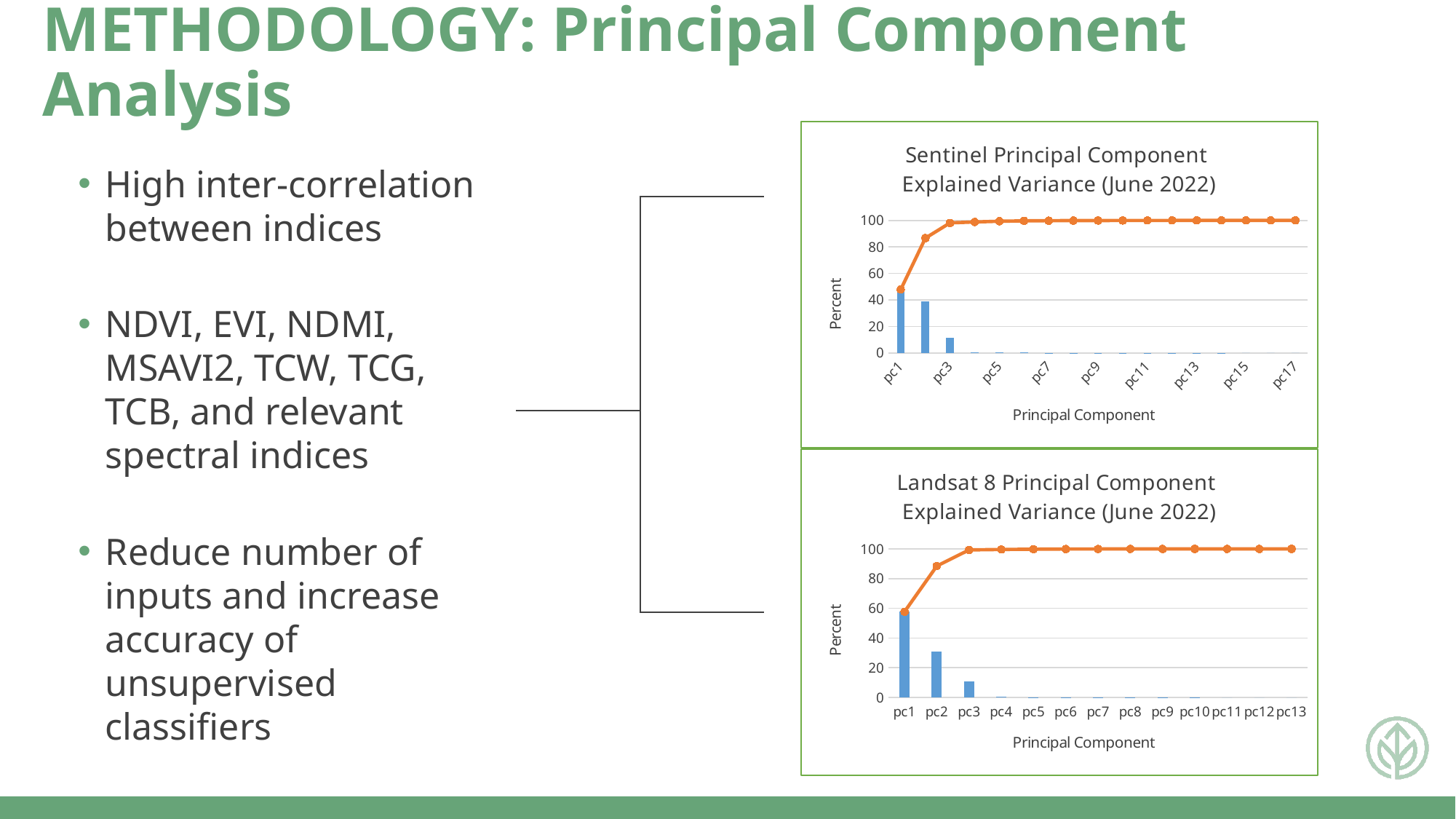
In the Landsat 8 Principal Component Explained Variance chart, which principal component has the tallest bar? pc1 What kind of chart is the Landsat 8 Principal Component Explained Variance chart? Bar chart with a line How many principal components are shown on the x axis of the Sentinel Principal Component Explained Variance chart? 17 How many principal components are shown on the x axis of the Landsat 8 Principal Component Explained Variance chart? 13 In the Sentinel Principal Component Explained Variance chart, is the bar for pc3 greater or less than 20? less In the Landsat 8 Principal Component Explained Variance chart, is the bar for pc2 greater or less than 20? greater What is the y-axis label on the Sentinel Principal Component Explained Variance chart? Percent In the Sentinel Principal Component Explained Variance chart, is the bar for pc1 greater or less than 40? greater In the Sentinel Principal Component Explained Variance chart, does the orange line rise or fall from pc1 to pc17? rise In the Landsat 8 Principal Component Explained Variance chart, which bar is taller, pc1 or pc2? pc1 In the Sentinel Principal Component Explained Variance chart, which principal component has the tallest bar? pc1